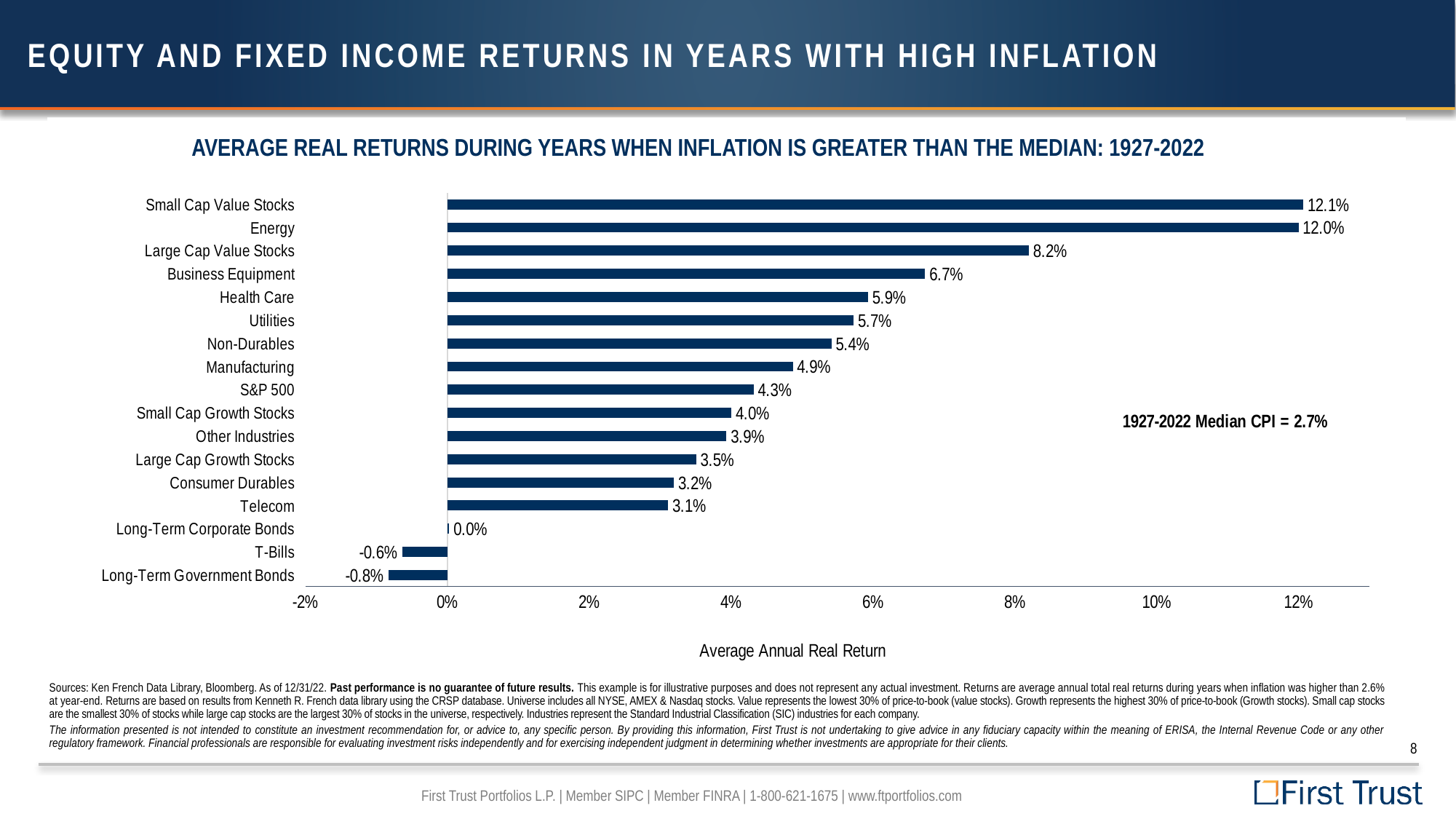
What median CPI value is noted on the chart for 1927-2022? 2.7% Which category has the lowest average annual real return? Long-Term Government Bonds What is the average annual real return for T-Bills? -0.6% How many categories are shown in the chart? 17 Which has a higher average annual real return, Health Care or Utilities? Health Care What is the average annual real return for Long-Term Corporate Bonds? 0.0% What is the chart's title? Average Real Returns During Years When Inflation Is Greater Than the Median: 1927-2022 What is the average annual real return for Energy? 12.0% What is the average annual real return for the S&P 500? 4.3% What is the difference between the returns for Large Cap Value Stocks and Large Cap Growth Stocks? 4.7% Which category has the highest average annual real return? Small Cap Value Stocks What kind of chart is shown on the slide? Bar chart